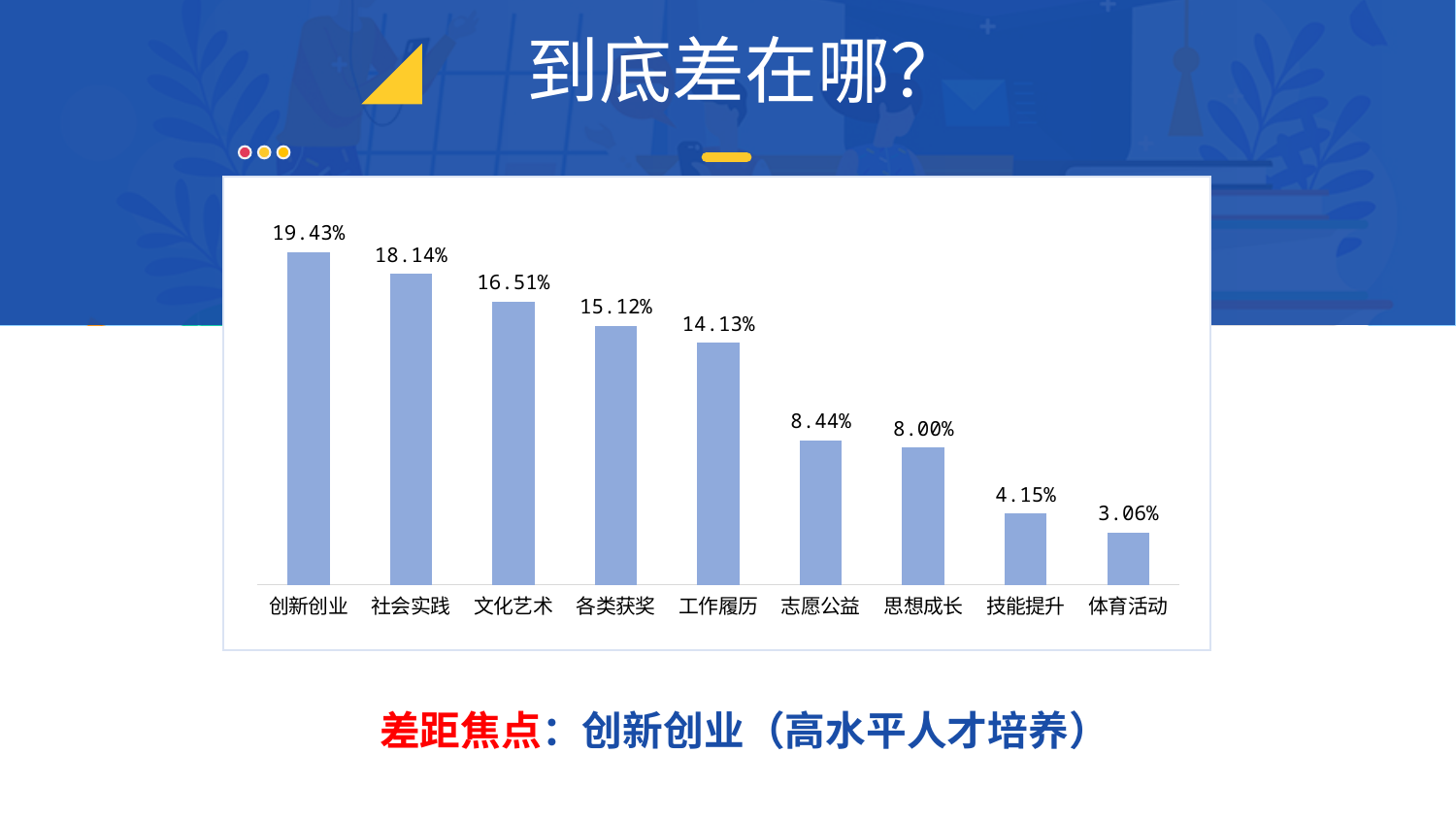
Which category has the highest value? 创新创业 What is the value for 创新创业? 19.43% What is the value for 志愿公益? 8.44% Which is larger, the value for 文化艺术 or the value for 工作履历? 文化艺术 Which category has the lowest value? 体育活动 How many categories are shown in the chart? 9 Do the values rise or fall from left to right along the x axis? Fall What is the value for 技能提升? 4.15% What is the difference between the values for 志愿公益 and 思想成长? 0.44% What kind of chart is shown on the slide? Bar chart What is the difference between the values for 创新创业 and 社会实践? 1.29% Which is larger, the value for 思想成长 or the value for 技能提升? 思想成长